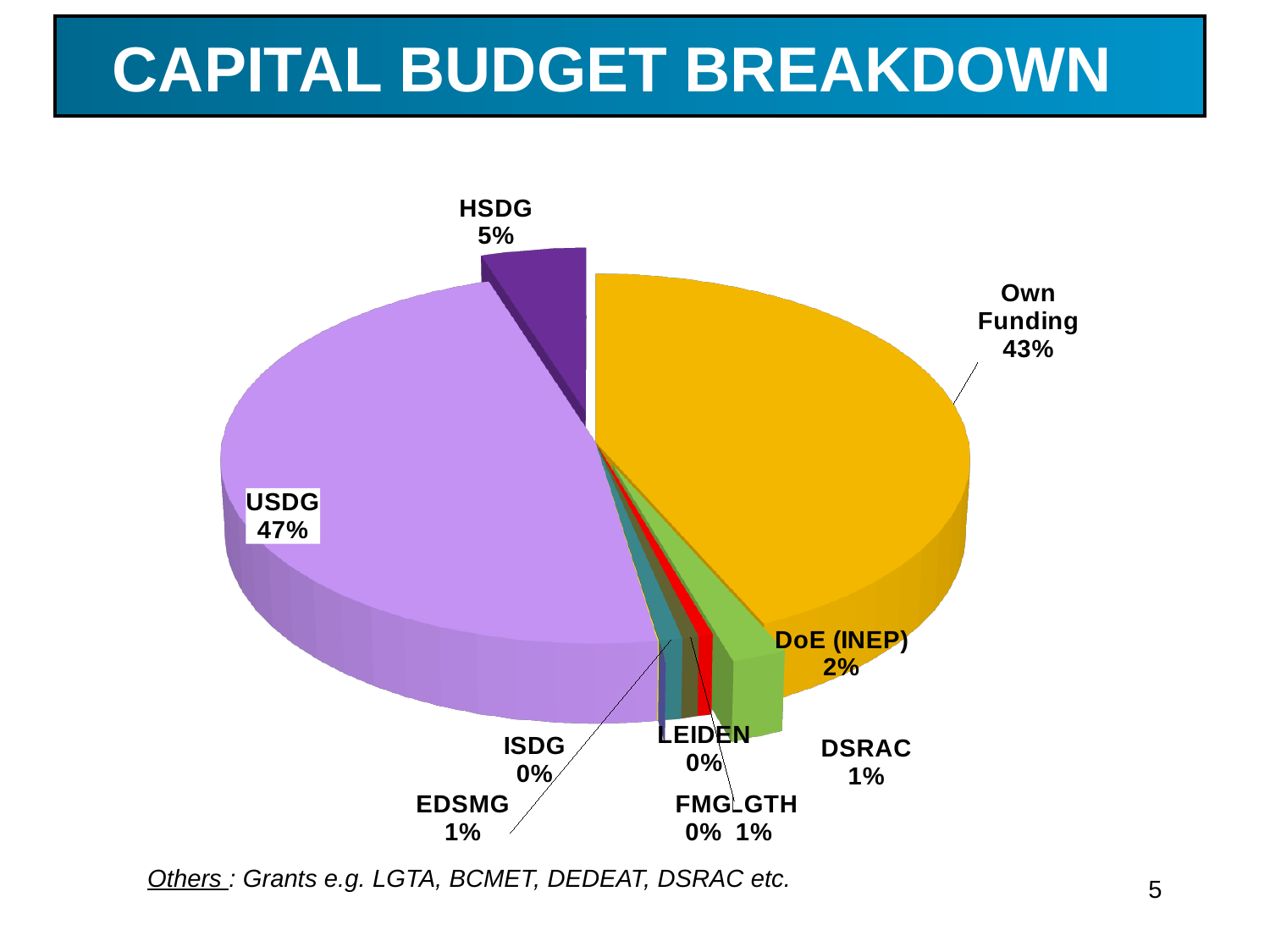
What percentage is shown for DoE (INEP)? 2% How many funding sources are labelled on the pie chart? 10 What percentage is shown for HSDG? 5% What colour is the USDG slice? light purple What percentage is shown for DSRAC? 1% What share of the capital budget comes from Own Funding? 43% What is the title of the chart? CAPITAL BUDGET BREAKDOWN What is the difference in percentage points between USDG and Own Funding? 4% Which is larger, the share for HSDG or the share for DoE (INEP)? HSDG Which funding source has the largest share of the capital budget? USDG What share of the capital budget comes from USDG? 47% What type of chart is shown on the slide? pie chart